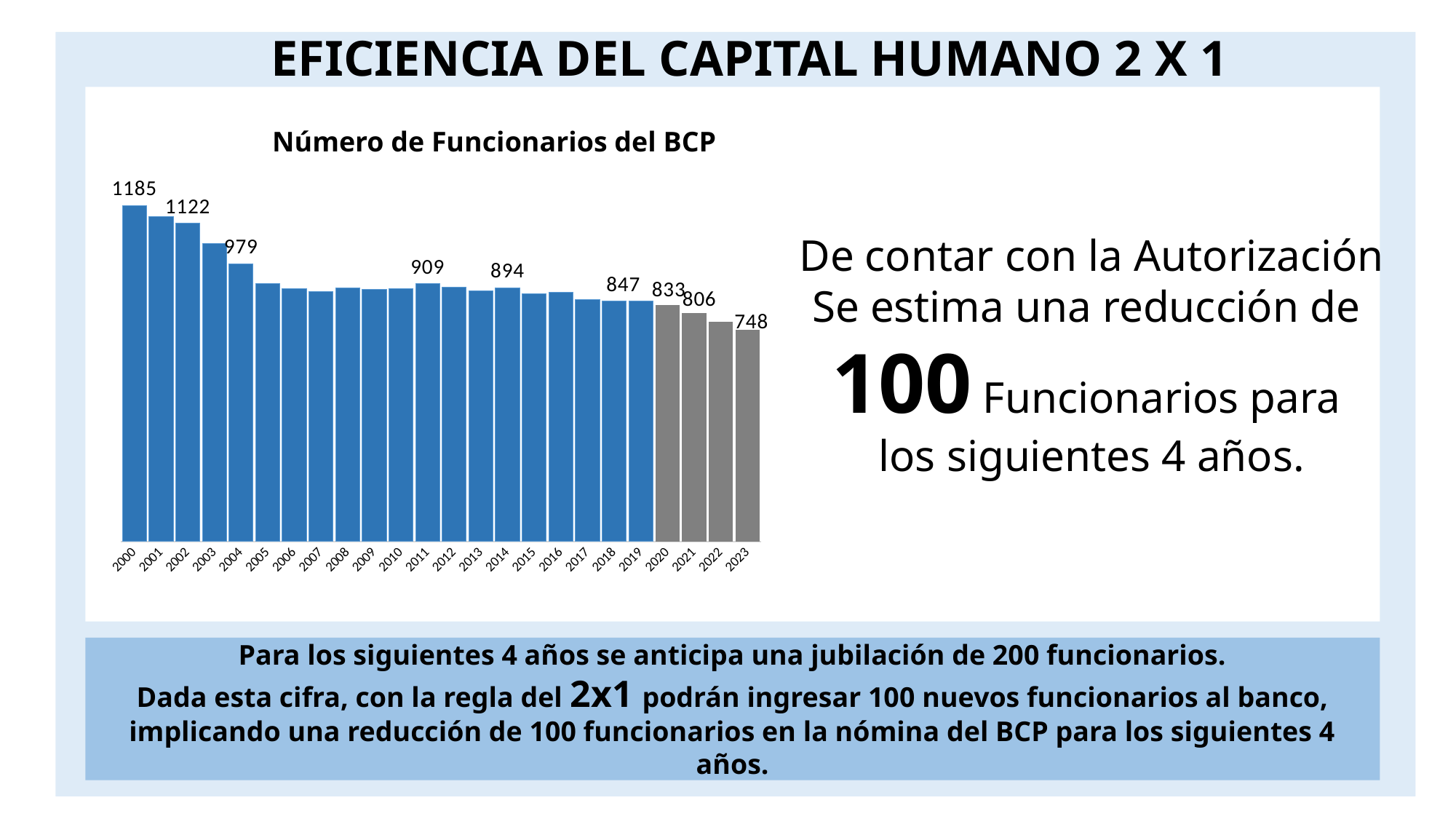
What is the number of funcionarios in 2011? 909 Which year has the lowest number of funcionarios? 2023 Do the values generally rise or fall from 2000 to 2023? Fall How many years (bars) are shown on the x axis of the chart? 24 What kind of chart is shown on the slide? Bar chart What is the number of funcionarios in 2023? 748 Which year has the highest number of funcionarios? 2000 Which year has more funcionarios, 2011 or 2014? 2011 What is the number of funcionarios in 2020? 833 What is the difference between the number of funcionarios in 2000 and in 2023? 437 What is the number of funcionarios in 2000? 1185 What is the title of the chart? Número de Funcionarios del BCP